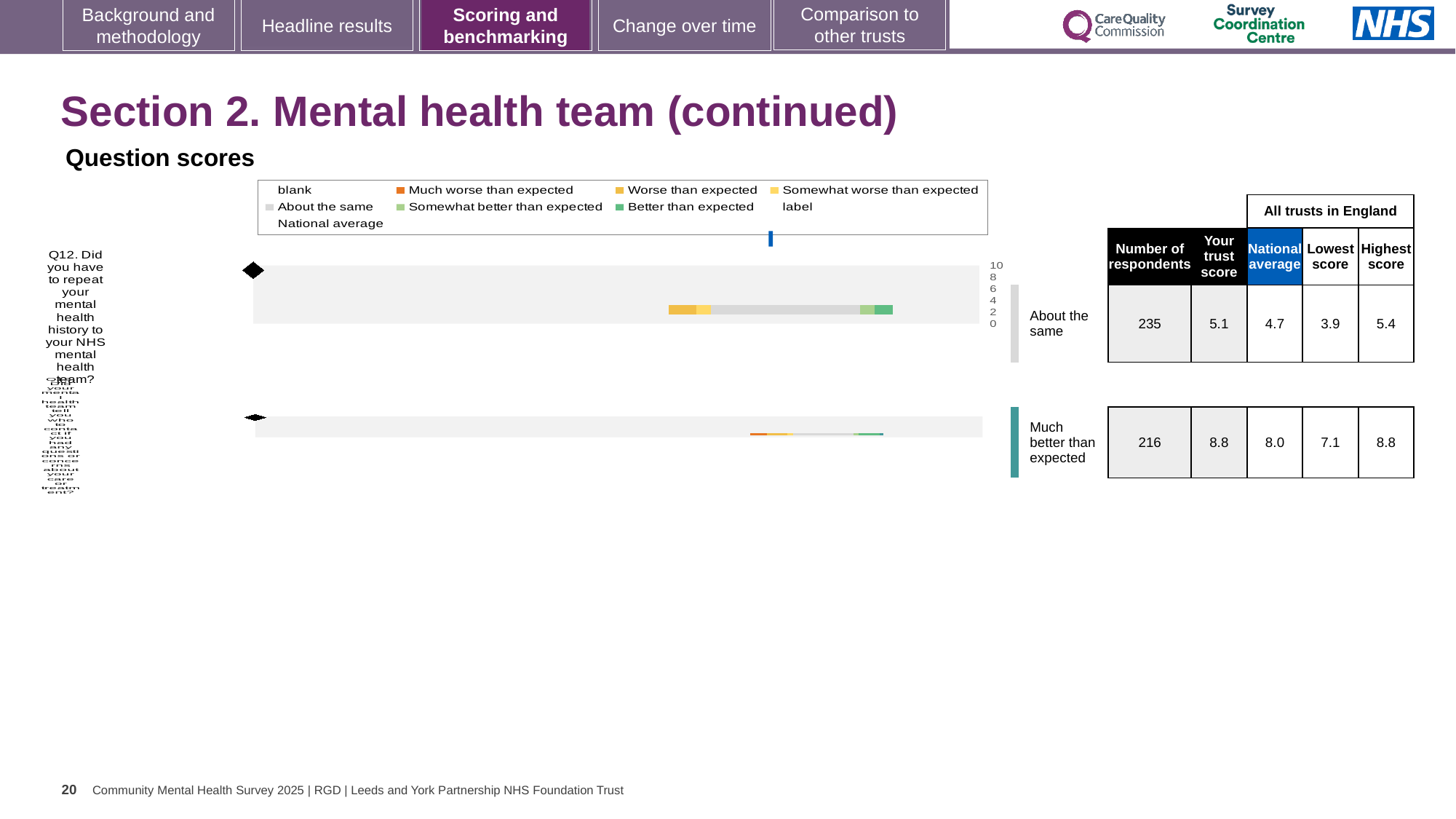
What is the trust score for the second question shown (the one rated 'Much better than expected')? 8.8 What is the national average for the second question shown (the one rated 'Much better than expected')? 8.0 What is the difference between the highest and lowest scores for the second question shown (the one rated 'Much better than expected')? 1.7 What is the national average score for Q12? 4.7 By how much does the trust score for Q12 exceed the national average? 0.4 What is the highest score among all trusts in England for Q12? 5.4 What is the lowest score among all trusts in England for Q12? 3.9 What benchmark category is Q12 placed in? About the same What kind of chart is used to show the question scores? Bar chart What is the trust score for Q12 (Did you have to repeat your mental health history to your NHS mental health team?)? 5.1 For Q12, which is larger: the trust score or the national average? The trust score (5.1) How many respondents answered Q12? 235